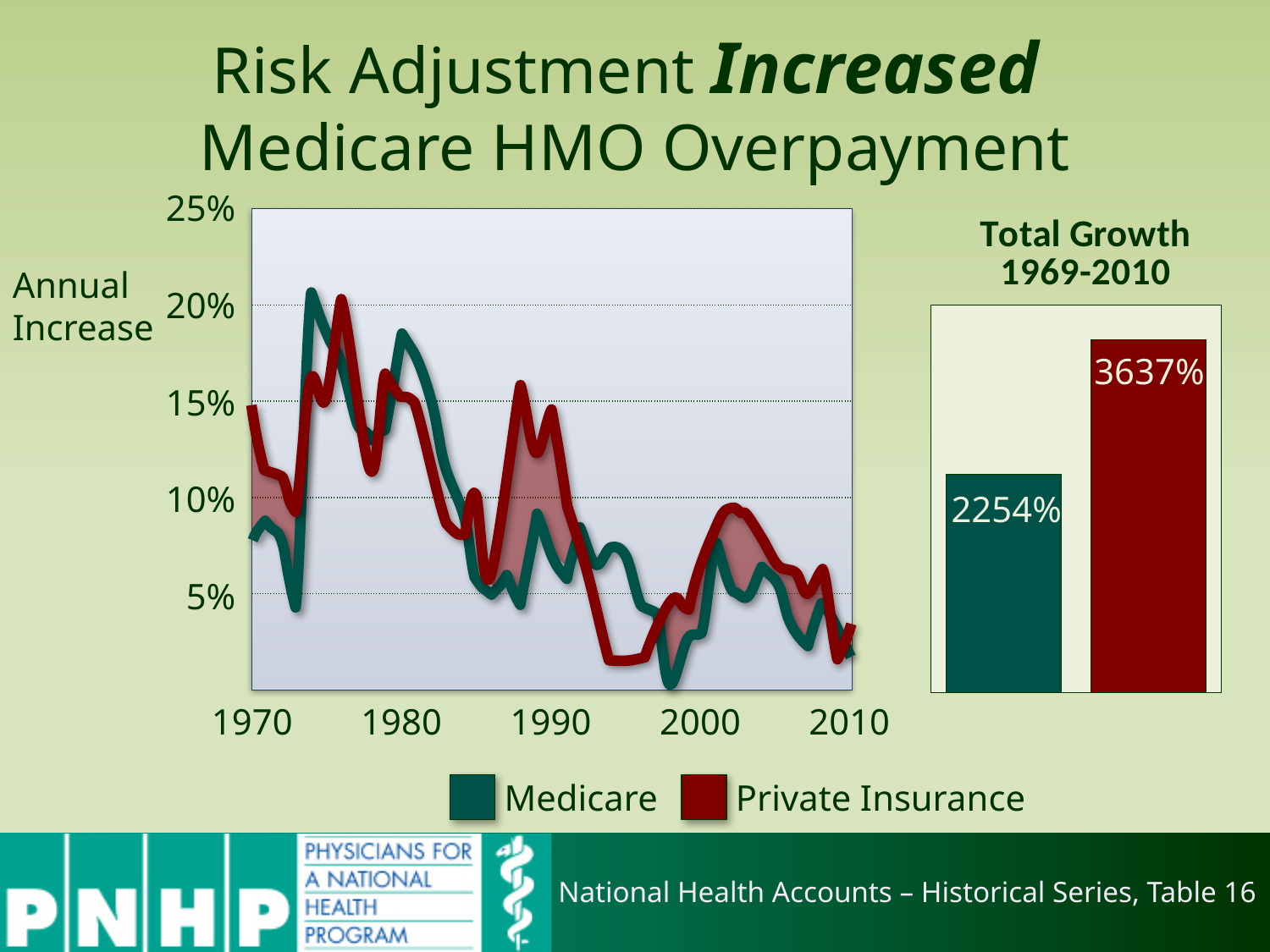
In the Annual Increase line chart, do the values generally rise or fall from 1970 to 2010? fall In the Annual Increase line chart, is the Private Insurance value around 1995 greater or less than 5%? less In the Annual Increase line chart, which colour represents Private Insurance? red In the Total Growth 1969-2010 bar chart, what is the difference between the Private Insurance and Medicare values? 1383% What kind of chart is the Annual Increase chart on the left? line chart In the Total Growth 1969-2010 bar chart, what is the value for Private Insurance? 3637% In the Total Growth 1969-2010 bar chart, which category has the higher value? Private Insurance In the Total Growth 1969-2010 bar chart, what is the value for Medicare? 2254% In the Annual Increase line chart, is the Medicare value in 1970 greater or less than 10%? less How many series does the legend of the Annual Increase line chart list? 2 In the Total Growth 1969-2010 bar chart, how many bars are shown? 2 What kind of chart is the Total Growth 1969-2010 chart on the right? bar chart